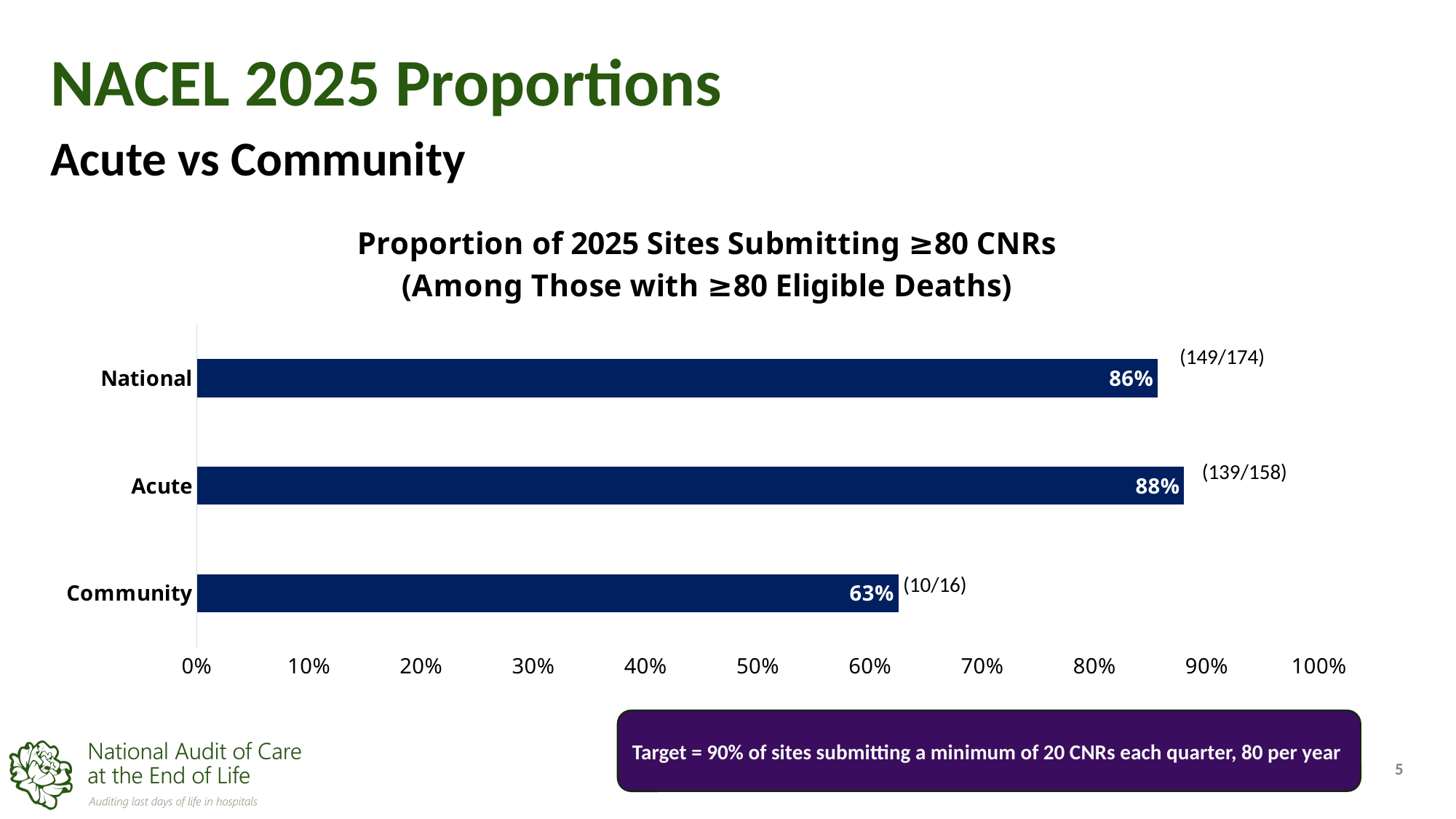
Which category has the highest proportion? Acute What is the value for Community? 63% How many categories are shown on the chart? 3 Is the value for Community greater or less than 70%? less What is the title of the chart? Proportion of 2025 Sites Submitting ≥80 CNRs (Among Those with ≥80 Eligible Deaths) Which is larger, the value for National or the value for Community? National What fraction is shown next to the Community bar? (10/16) Which category has the lowest proportion? Community What is the value for National? 86% What kind of chart is shown? Bar chart What is the difference between the Acute and Community values? 25% What is the value for Acute? 88%